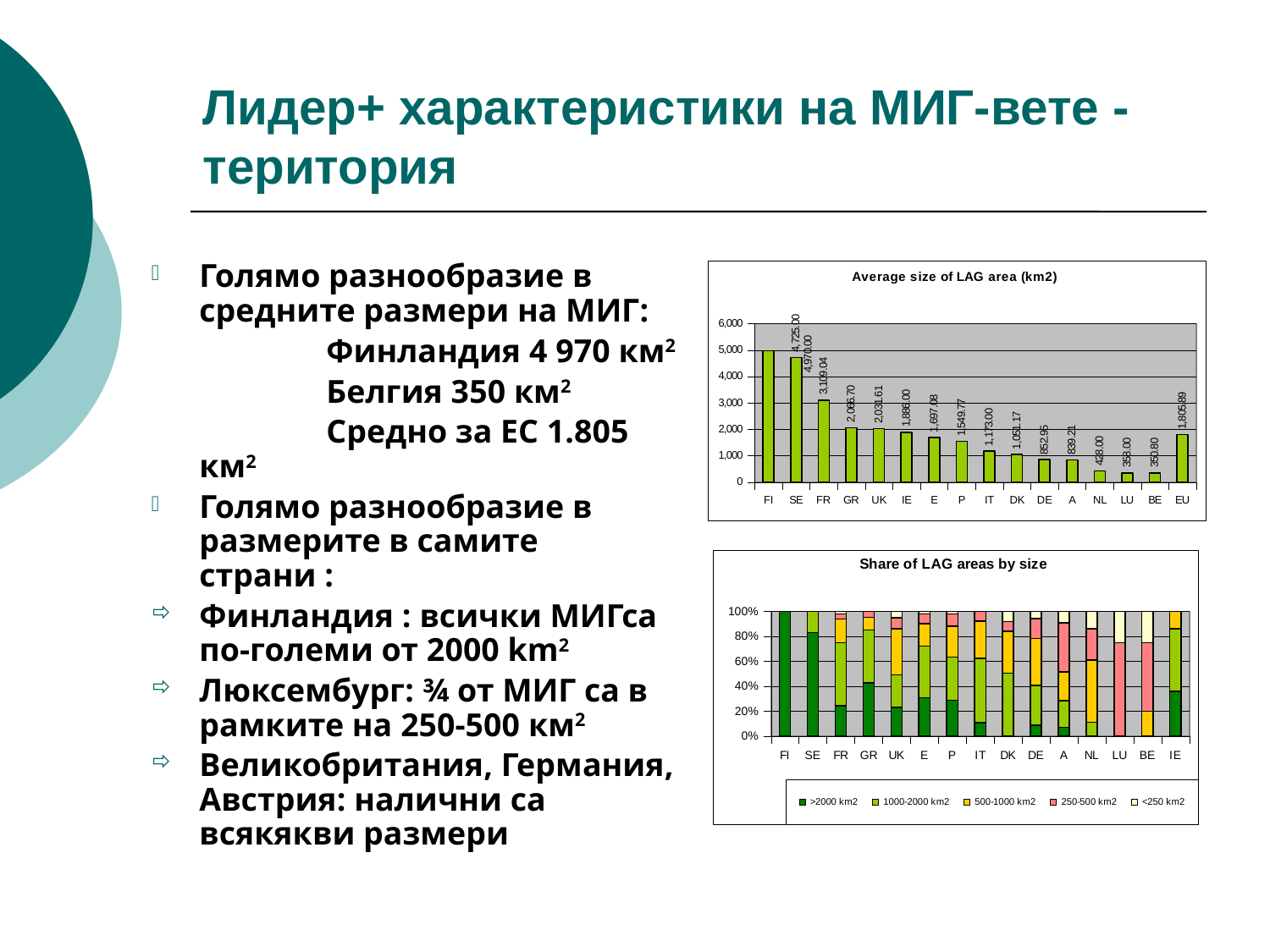
In the 'Average size of LAG area (km2)' chart, what is the value for BE? 350.80 In the 'Average size of LAG area (km2)' chart, how many categories are shown on the x axis? 16 In the 'Average size of LAG area (km2)' chart, what is the difference between the values for NL and LU? 70.00 In the 'Average size of LAG area (km2)' chart, which is larger, the value for IT or the value for DK? IT In the 'Average size of LAG area (km2)' chart, is the value for IE greater or less than 2,000? less What kind of chart is the 'Average size of LAG area (km2)' chart? bar chart In the 'Average size of LAG area (km2)' chart, which category has the lowest value? BE In the 'Average size of LAG area (km2)' chart, what is the value for FR? 3,109.04 In the 'Share of LAG areas by size' chart, how many countries are shown on the x axis? 15 In the 'Average size of LAG area (km2)' chart, which category has the highest value? FI In the 'Average size of LAG area (km2)' chart, what is the value for EU? 1,805.89 How many series does the legend of the 'Share of LAG areas by size' chart list? 5